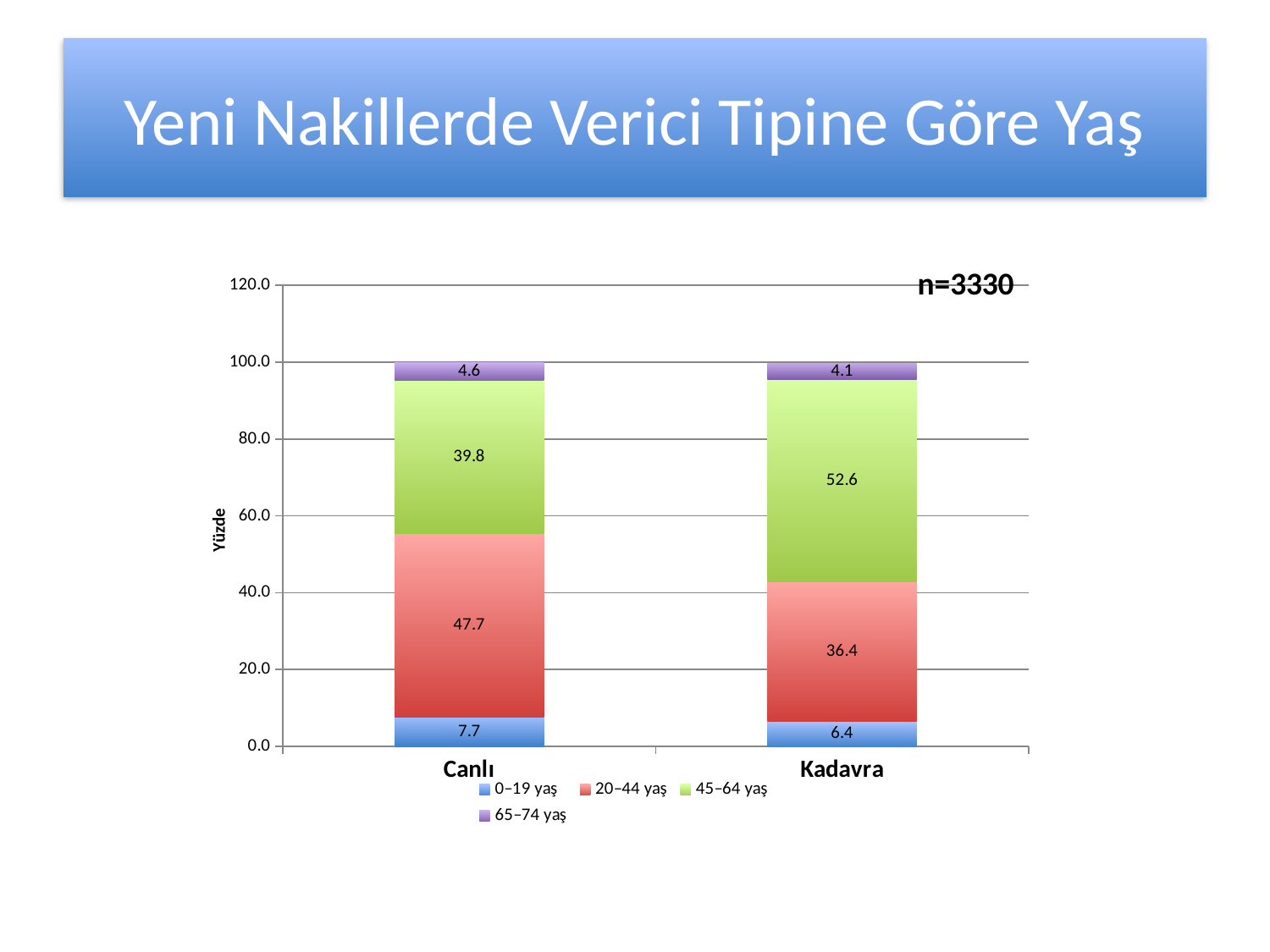
What kind of chart is shown on the slide? Stacked bar chart What is the value for the 0–19 yaş series in the Kadavra bar? 6.4 What is the value for the 65–74 yaş series in the Canlı bar? 4.6 What is the difference between the 0–19 yaş values for Canlı and Kadavra? 1.3 How many series does the legend list? 4 Which category has the higher value for the 20–44 yaş series, Canlı or Kadavra? Canlı Which series has the smallest value within the Kadavra bar? 65–74 yaş What is the value for the 20–44 yaş series in the Canlı bar? 47.7 What is the value for the 45–64 yaş series in the Kadavra bar? 52.6 Which category has the higher value for the 45–64 yaş series, Canlı or Kadavra? Kadavra What is the difference between the 45–64 yaş values for Kadavra and Canlı? 12.8 Which series has the largest value within the Canlı bar? 20–44 yaş